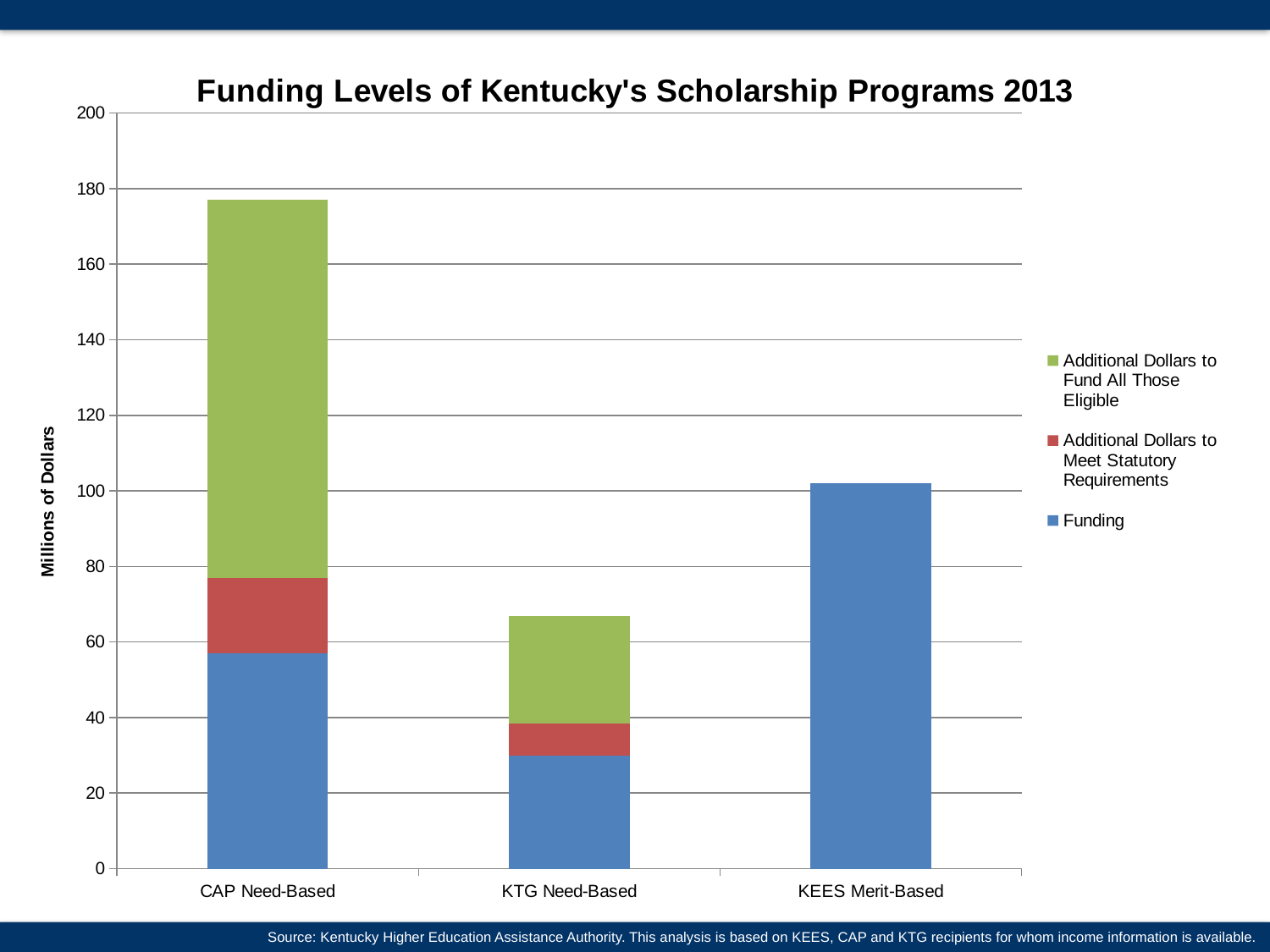
How many series does the legend list? 3 How many scholarship programs (categories) are shown on the x axis? 3 Which program has the shortest stacked bar overall? KTG Need-Based Which is larger: the total bar for CAP Need-Based or the total bar for KEES Merit-Based? CAP Need-Based Is the Funding value for KTG Need-Based greater or less than 40? less Is the Funding value for KEES Merit-Based greater or less than 80? greater What kind of chart is shown on the slide? Stacked bar chart Is the total height of the CAP Need-Based bar greater or less than 160? greater What is the title of the chart? Funding Levels of Kentucky's Scholarship Programs 2013 Which program has the largest Funding segment? KEES Merit-Based Which program has the tallest stacked bar overall? CAP Need-Based